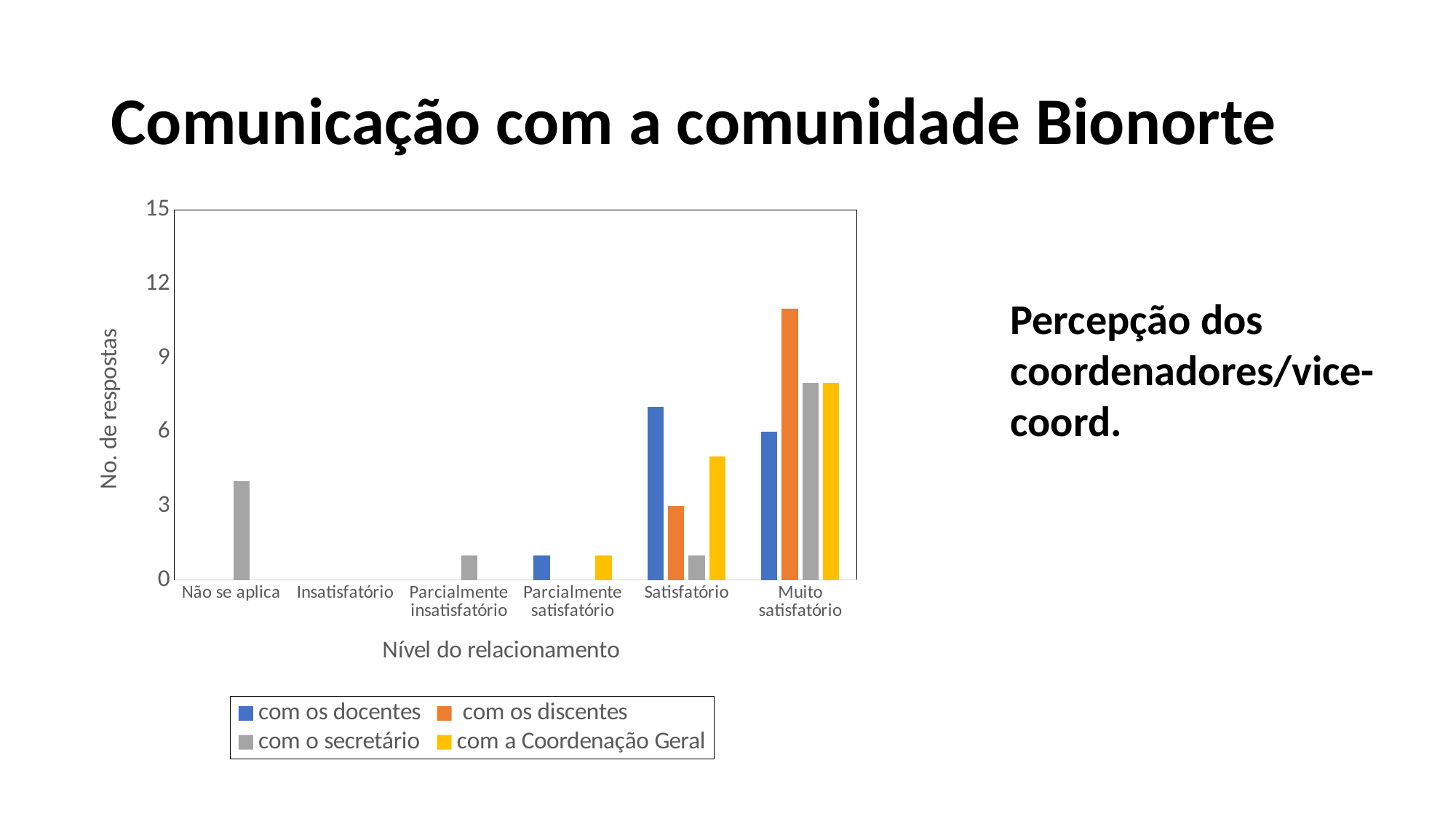
Which series has the tallest bar in the whole chart? com os discentes Is the value for 'com a Coordenação Geral' in 'Satisfatório' greater or less than 6? less How many series does the legend list? 4 What kind of chart is shown on the slide? bar chart In the 'Muito satisfatório' category, which series has the highest value? com os discentes What is the title of the y axis? No. de respostas How many categories are shown on the x axis? 6 Is the value for 'com os discentes' in 'Muito satisfatório' greater or less than 9? greater In the 'Satisfatório' category, which series has the lowest value? com o secretário Is the value for 'com o secretário' in 'Não se aplica' greater or less than 3? greater In the 'Muito satisfatório' category, which is larger: 'com os docentes' or 'com os discentes'? com os discentes In the 'Satisfatório' category, which series has the highest value? com os docentes